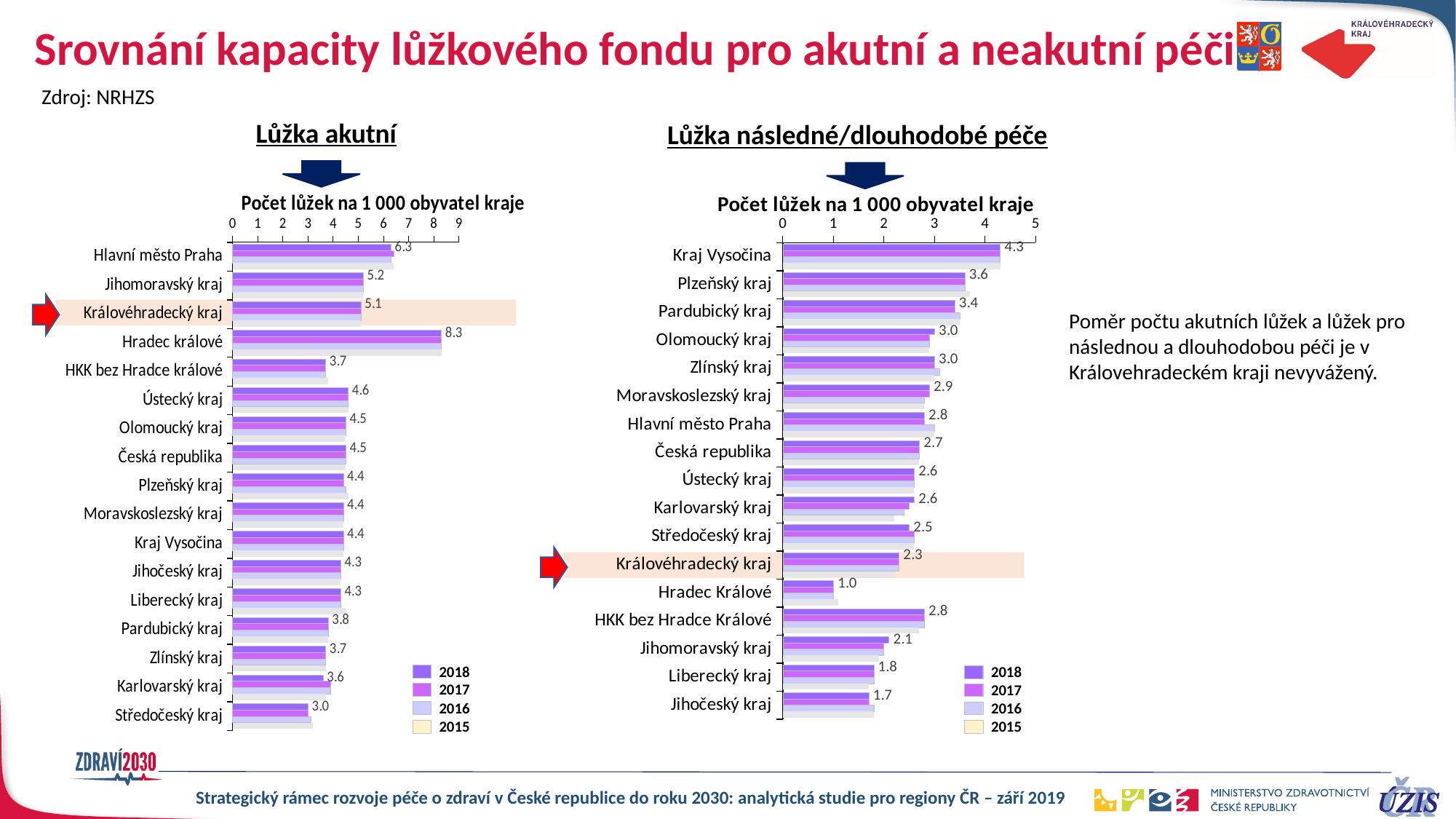
How many categories are shown in the 'Lůžka následné/dlouhodobé péče' chart? 17 In the 'Lůžka následné/dlouhodobé péče' chart, which has the larger labelled value, Plzeňský kraj or Jihočeský kraj? Plzeňský kraj In the 'Lůžka akutní' chart, which category has the lowest labelled value? Středočeský kraj In the 'Lůžka následné/dlouhodobé péče' chart, which category has the lowest labelled value? Hradec Králové In the 'Lůžka akutní' chart, what is the difference between the labelled values for Hlavní město Praha and Středočeský kraj? 3.3 In the 'Lůžka akutní' chart, what is the labelled 2018 value for Královéhradecký kraj? 5.1 In the 'Lůžka následné/dlouhodobé péče' chart, what is the labelled 2018 value for Hradec Králové? 1.0 How many series does the legend of the 'Lůžka akutní' chart list? 4 In the 'Lůžka akutní' chart, which category has the highest labelled value? Hradec králové In the 'Lůžka následné/dlouhodobé péče' chart, what is the labelled 2018 value for Kraj Vysočina? 4.3 In the 'Lůžka akutní' chart, what is the labelled 2018 value for Hradec králové? 8.3 What kind of chart is the 'Lůžka akutní' chart? Bar chart